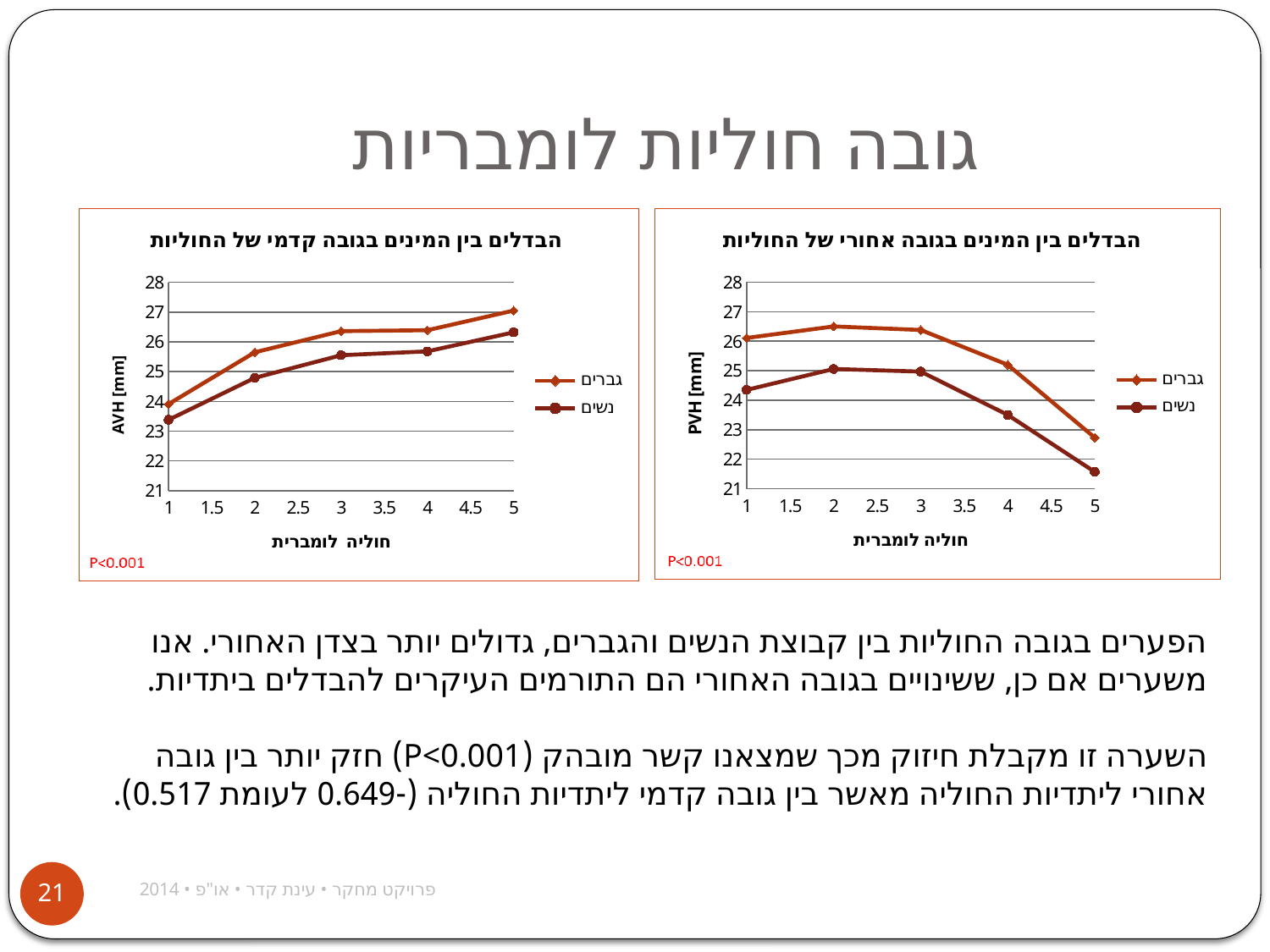
In the right chart (PVH [mm]), which series has the larger value at vertebra 1, גברים or נשים? גברים What is the y-axis label of the right chart? PVH [mm] In the left chart (AVH [mm]), do the values for גברים rise or fall from vertebra 1 to vertebra 5? rise In the right chart (PVH [mm]), do the values for נשים rise or fall from vertebra 3 to vertebra 5? fall In the left chart (AVH [mm]), is the value for גברים at vertebra 5 greater or less than 26? greater In the left chart (AVH [mm]), is the value for נשים at vertebra 1 greater or less than 24? less How many series does the legend of the right chart, titled 'הבדלים בין המינים בגובה אחורי של החוליות', list? 2 In the left chart (AVH [mm]), at which vertebra is the value for גברים highest? 5 In the right chart (PVH [mm]), at which vertebra is the value for גברים lowest? 5 What kind of chart is the left chart, titled 'הבדלים בין המינים בגובה קדמי של החוליות'? line chart In the left chart (AVH [mm]), how many lumbar vertebrae (x-axis points) are plotted for each series? 5 In the right chart (PVH [mm]), is the value for נשים at vertebra 5 greater or less than 22? less